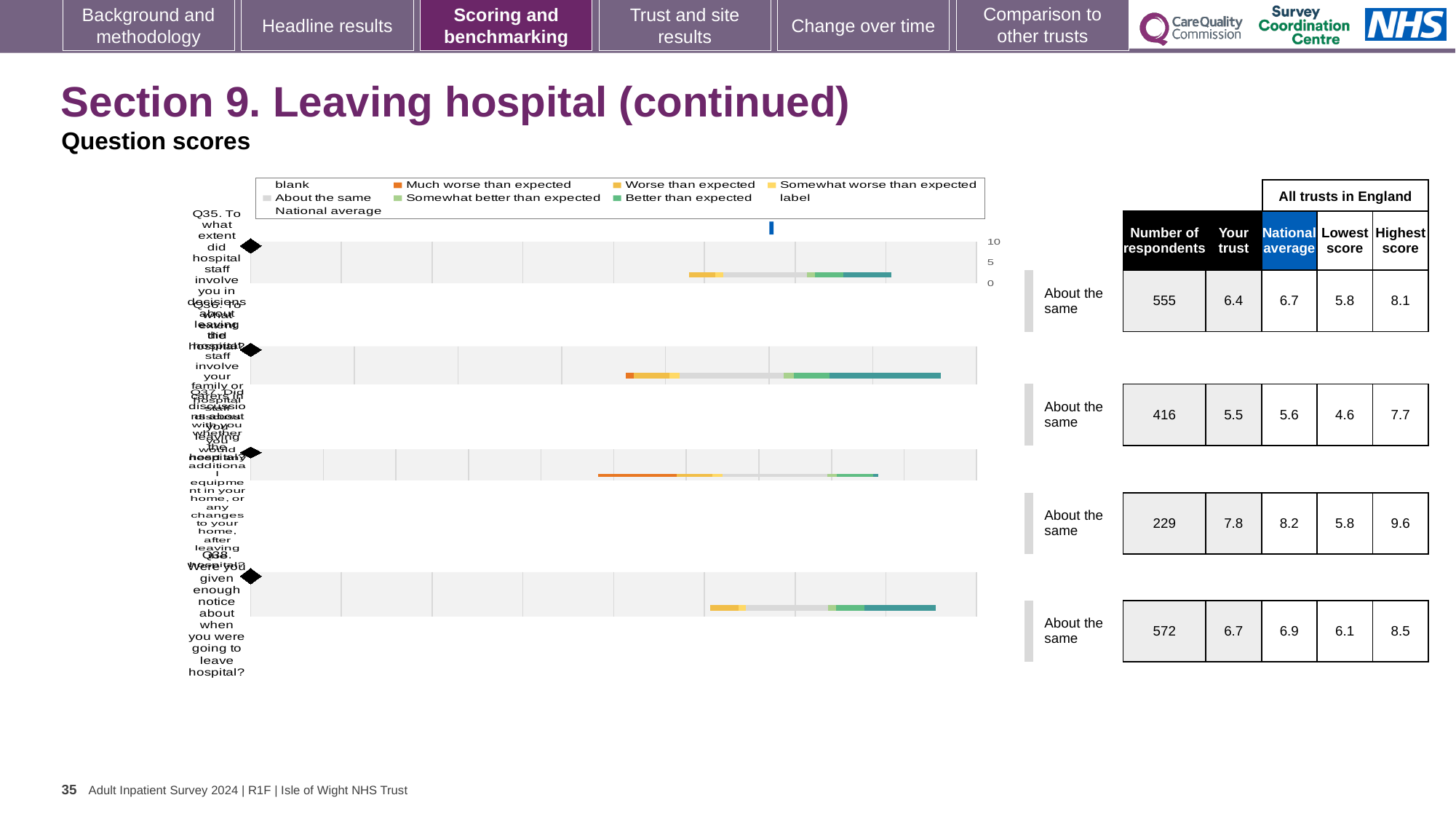
For Q38, which is larger: the 'Your trust' score or the national average? national average How many question bars are plotted in the chart? 4 What benchmark category label is shown next to each of the four bars? About the same What is the lowest score across all trusts in England for the second bar (Q36)? 4.6 Which bar has the highest 'Highest score' value in the table? the third bar (Q37), 9.6 What kind of chart is shown on the slide? bar chart What is the 'Your trust' score for Q38 (the last bar)? 6.7 How many entries does the chart legend list? 9 What is the national average for the third bar (Q37)? 8.2 What is the number of respondents for Q35 (the first bar)? 555 Which bar has the lowest 'Your trust' score? the second bar (Q36), 5.5 For Q35, what is the difference between the national average and the 'Your trust' score? 0.3